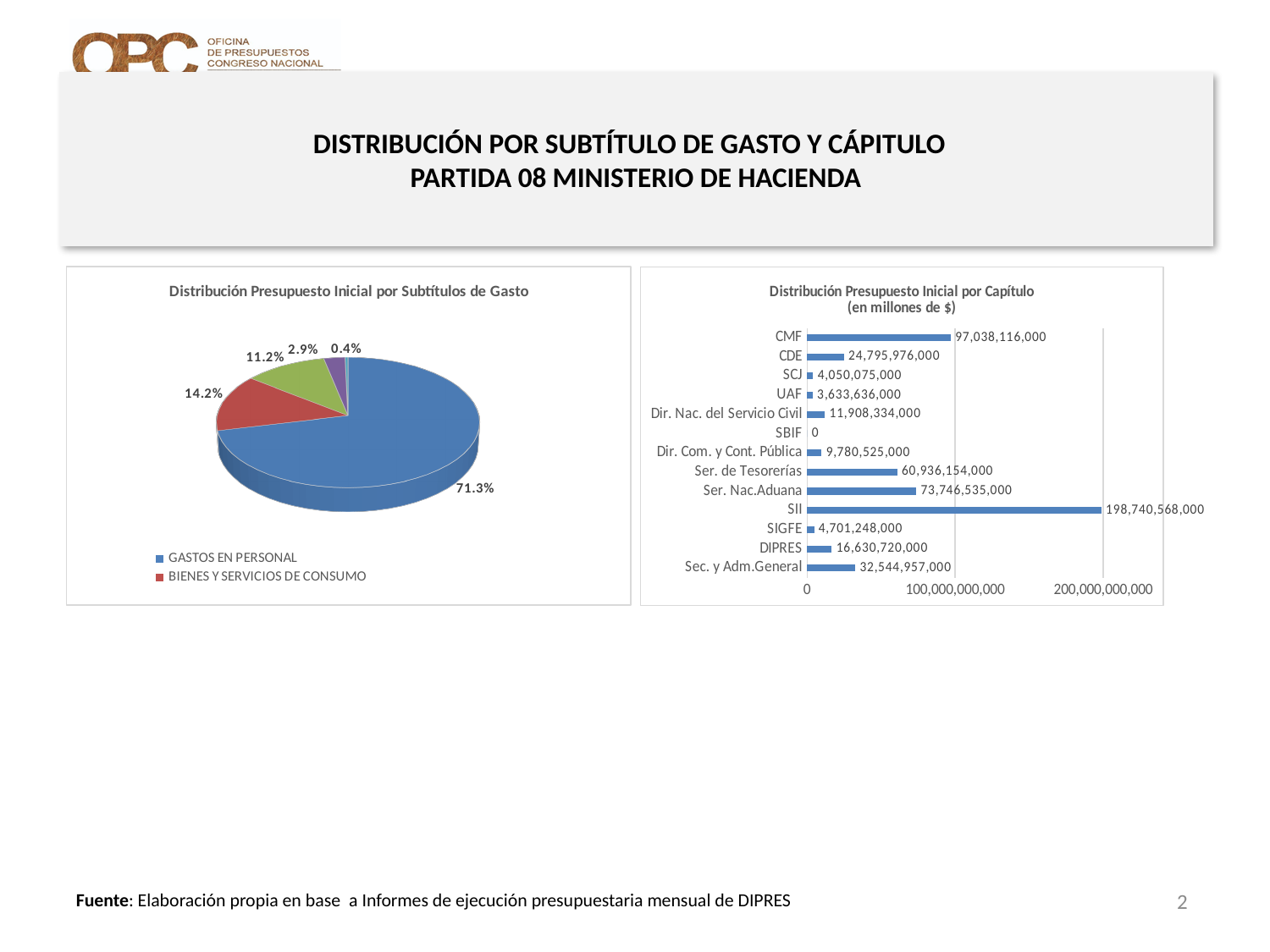
What kind of chart is the chart on the left of the slide? Pie chart In the pie chart 'Distribución Presupuesto Inicial por Subtítulos de Gasto', what share does GASTOS EN PERSONAL have? 71.3% What kind of chart is 'Distribución Presupuesto Inicial por Capítulo'? Bar chart In the chart 'Distribución Presupuesto Inicial por Capítulo', how many capítulos are listed? 13 In the pie chart on the left, what is the smallest percentage shown? 0.4% In the chart 'Distribución Presupuesto Inicial por Capítulo', what is the value for CMF? 97,038,116,000 In the chart 'Distribución Presupuesto Inicial por Capítulo', which is larger, Ser. Nac.Aduana or Ser. de Tesorerías? Ser. Nac.Aduana In the chart 'Distribución Presupuesto Inicial por Capítulo', what is the value for SBIF? 0 In the chart 'Distribución Presupuesto Inicial por Capítulo', which capítulo has the highest value? SII In the chart 'Distribución Presupuesto Inicial por Capítulo', what is the value for SII? 198,740,568,000 In the pie chart 'Distribución Presupuesto Inicial por Subtítulos de Gasto', what share does BIENES Y SERVICIOS DE CONSUMO have? 14.2% In the chart 'Distribución Presupuesto Inicial por Capítulo', what is the difference between SII and CMF? 101,702,452,000